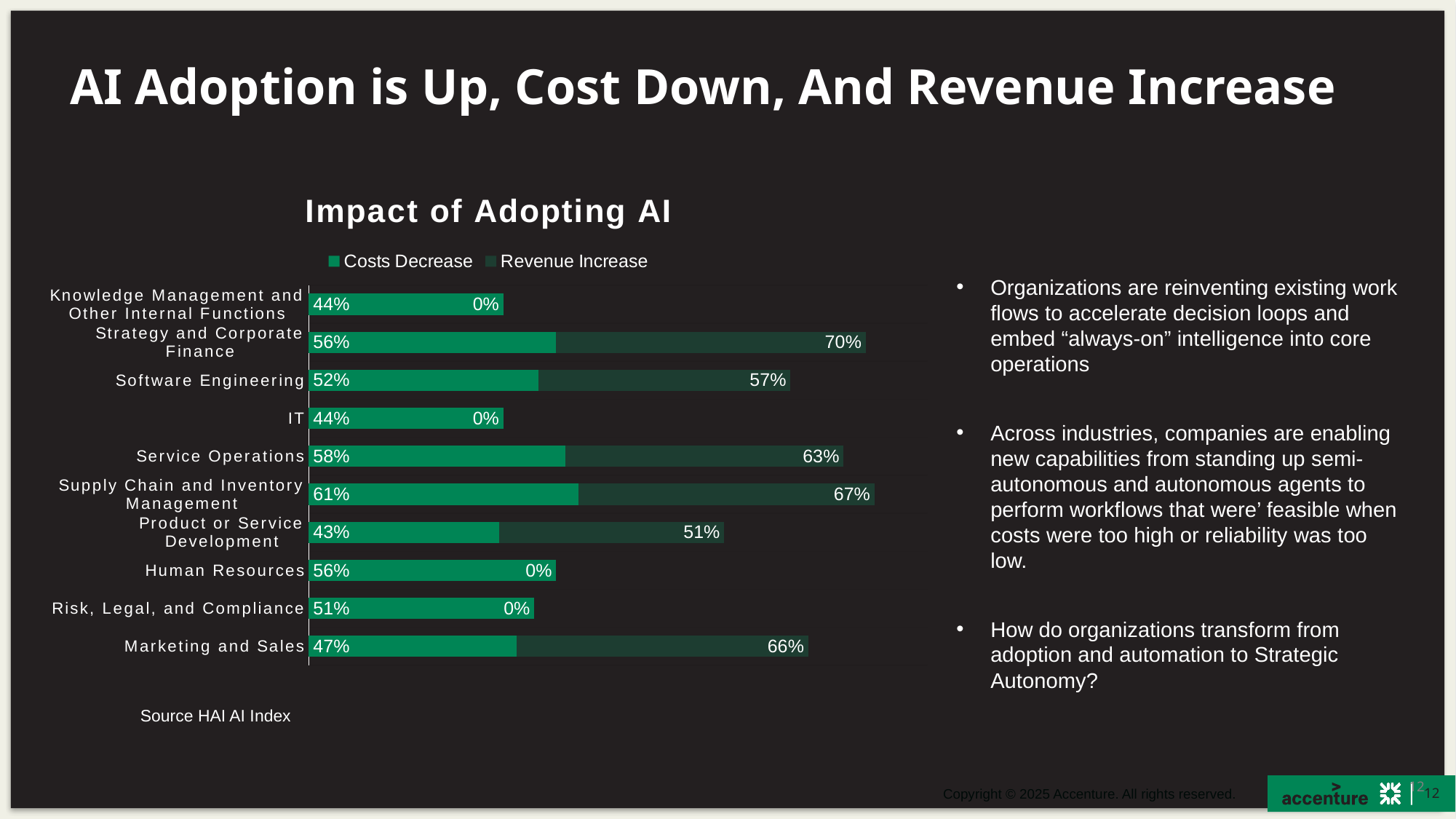
What is the Revenue Increase value for Human Resources? 0% How many series does the legend of the 'Impact of Adopting AI' chart list? 2 Which is larger: the Costs Decrease value for Service Operations or for Marketing and Sales? Service Operations What is the Costs Decrease value for Supply Chain and Inventory Management? 61% Which category has the lowest Costs Decrease value? Product or Service Development How many categories are shown in the 'Impact of Adopting AI' chart? 10 What are the two series named in the chart legend? Costs Decrease and Revenue Increase Which category has the highest Revenue Increase value? Strategy and Corporate Finance Which category has the highest Costs Decrease value? Supply Chain and Inventory Management What is the Revenue Increase value for Marketing and Sales? 66% What is the difference between the Revenue Increase values for Strategy and Corporate Finance and Software Engineering? 13% What type of chart is shown on the slide? Bar chart